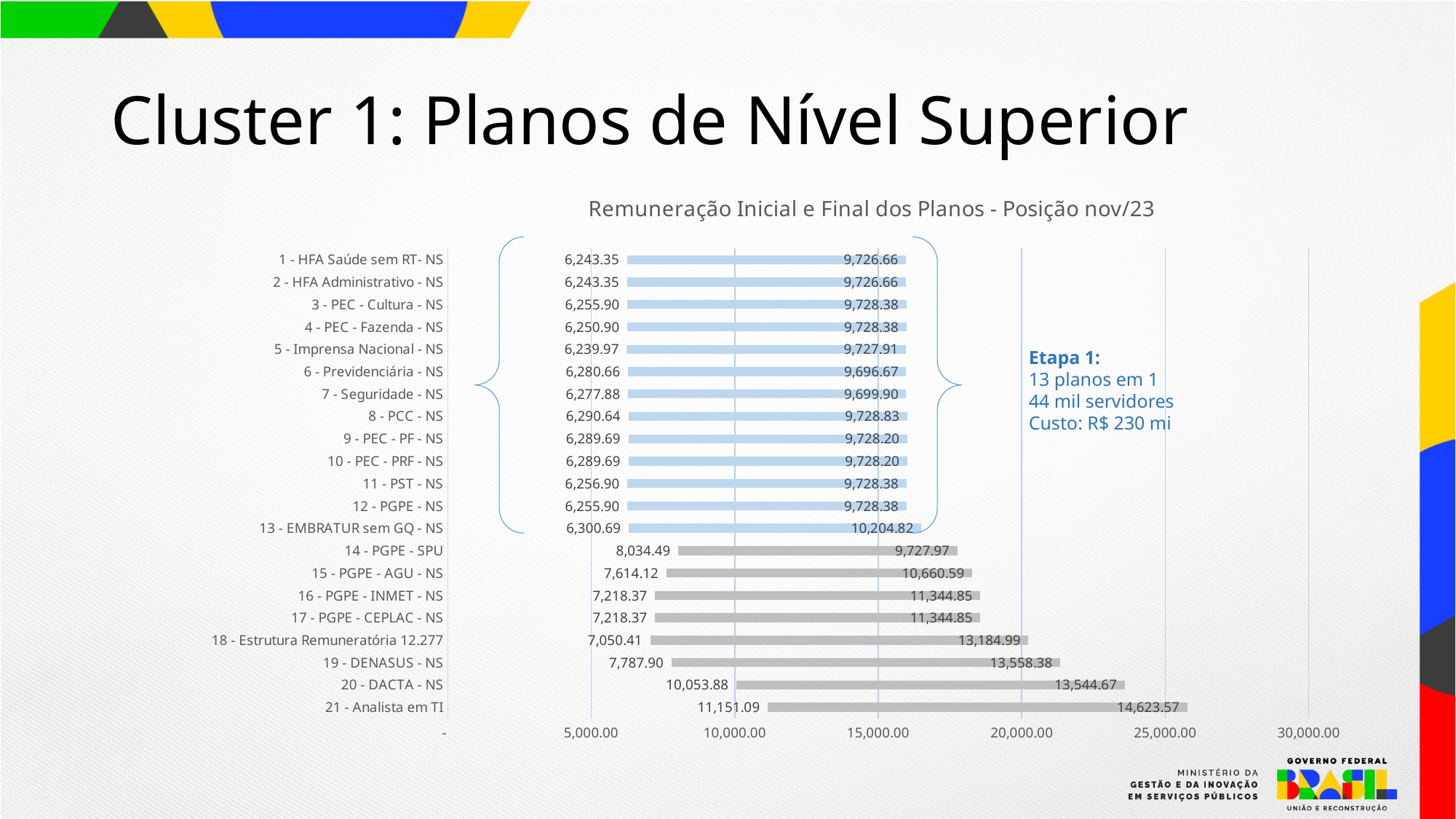
Which has a larger final remuneration value: 18 - Estrutura Remuneratória 12.277 or 16 - PGPE - INMET - NS? 18 - Estrutura Remuneratória 12.277 According to the annotation next to the chart, how many plans are grouped into one in Etapa 1? 13 What is the title of the chart? Remuneração Inicial e Final dos Planos - Posição nov/23 Which plan has the highest final remuneration value? 21 - Analista em TI How many plans (categories) are listed on the chart? 21 What is the initial remuneration value shown for 13 - EMBRATUR sem GQ - NS? 6,300.69 What is the final remuneration value shown for 15 - PGPE - AGU - NS? 10,660.59 What is the difference between the final and initial remuneration values for 21 - Analista em TI? 3,472.48 What type of chart is shown on the slide? Bar chart Which plan has the lowest initial remuneration value? 5 - Imprensa Nacional - NS What is the initial remuneration value shown for 20 - DACTA - NS? 10,053.88 What is the final remuneration value shown for 21 - Analista em TI? 14,623.57